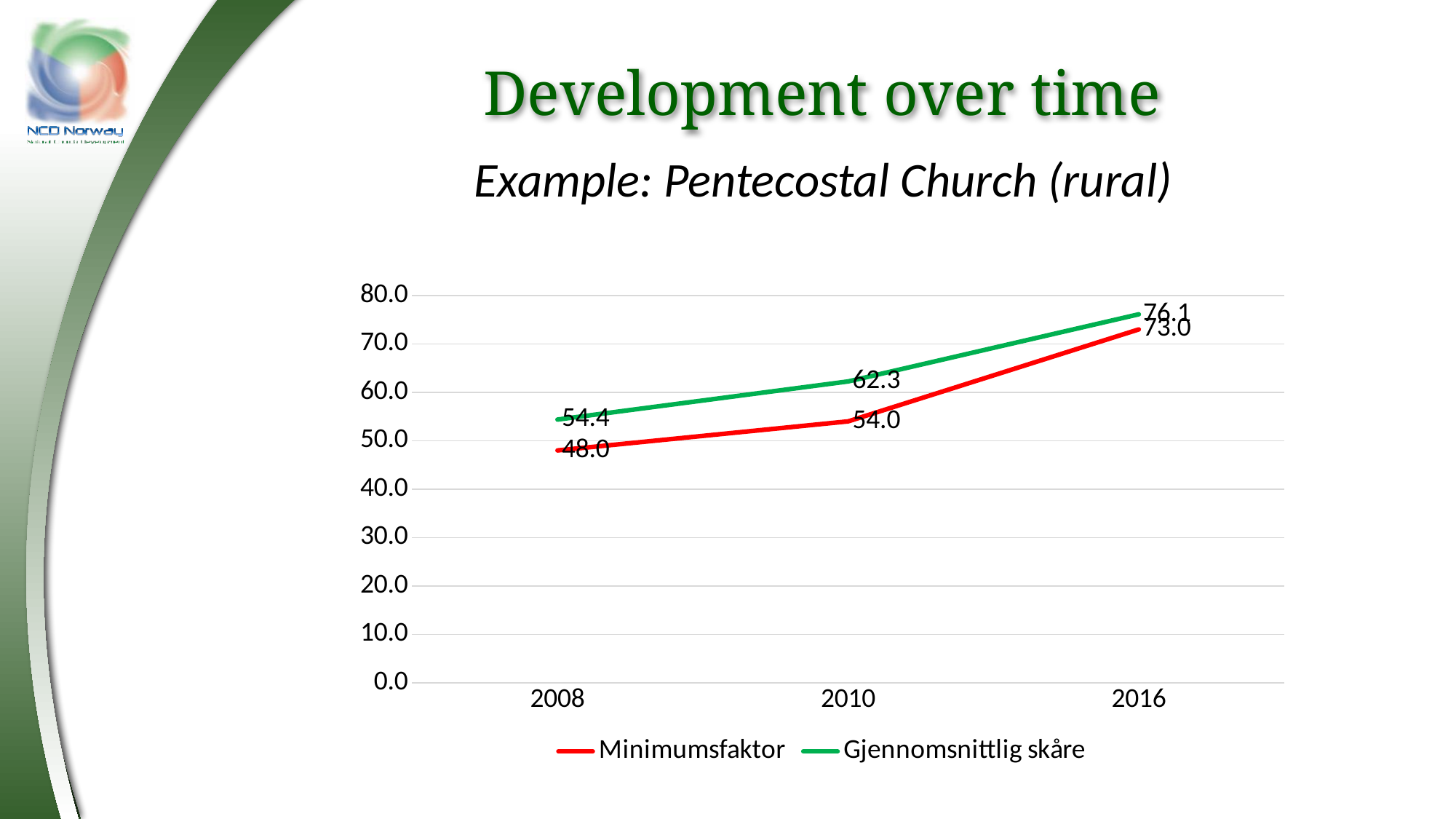
What is the value of Gjennomsnittlig skåre in 2008? 54.4 How many series does the legend list? 2 Which series has the higher value in 2016, Minimumsfaktor or Gjennomsnittlig skåre? Gjennomsnittlig skåre What is the value of Minimumsfaktor in 2016? 73.0 What is the difference between Gjennomsnittlig skåre and Minimumsfaktor in 2010? 8.3 Does Minimumsfaktor rise or fall from 2008 to 2016? rise In which year is Gjennomsnittlig skåre highest? 2016 In which year is Minimumsfaktor lowest? 2008 What is the value of Minimumsfaktor in 2008? 48.0 What is the value of Gjennomsnittlig skåre in 2010? 62.3 What type of chart is shown on the slide? line chart How many years are shown on the x axis? 3